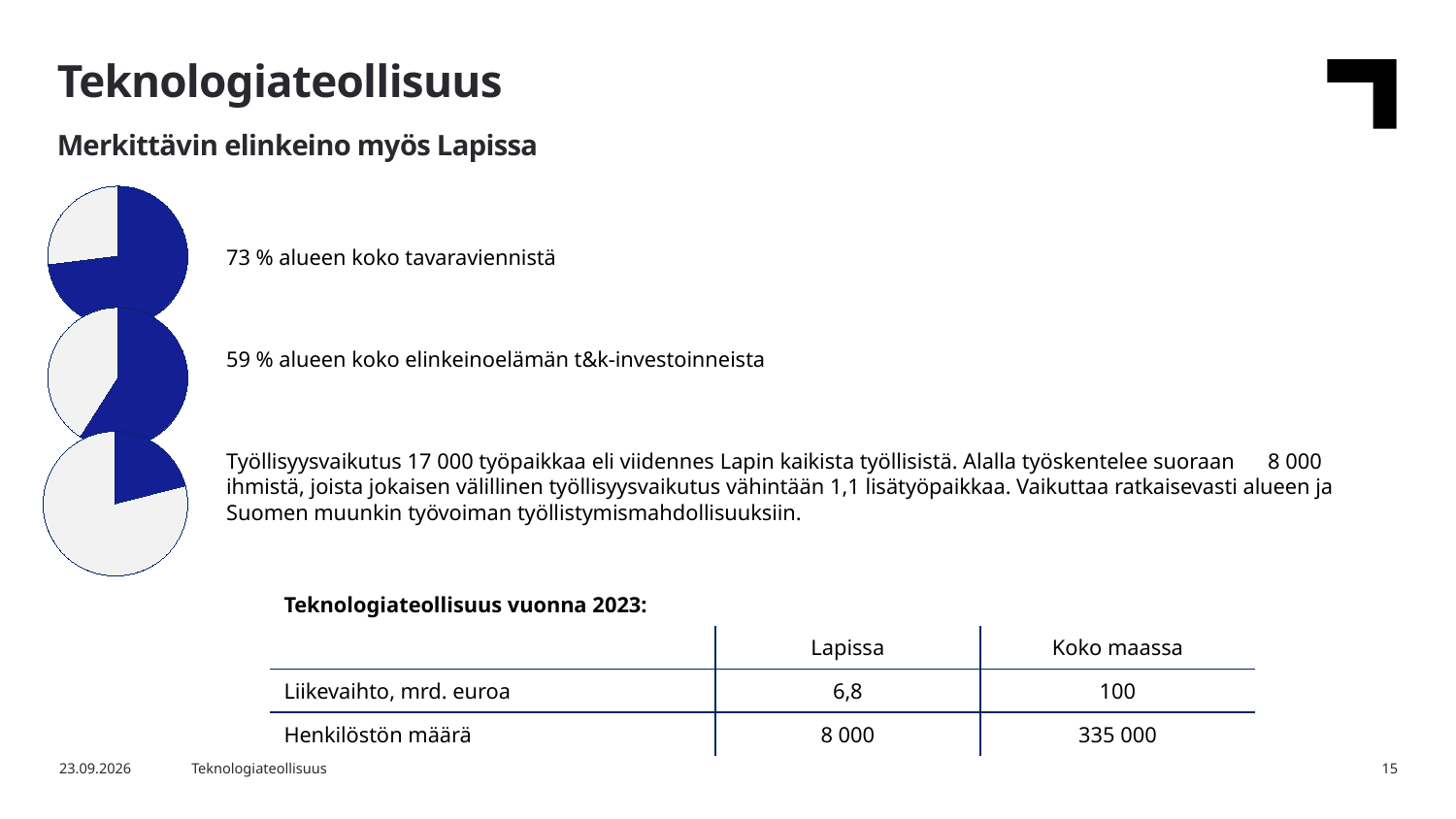
What kind of charts are shown on the left side of the slide? Pie charts What does the top pie chart's blue slice represent, according to the text next to it? 73 % alueen koko tavaraviennistä How many pie charts are on the slide? 3 Which of the three pie charts has the smallest blue slice? The bottom one Which of the three pie charts has the largest blue slice? The top one (73 %) What colour is used for the highlighted slice in each pie chart? Dark blue Is the blue slice in the top pie chart larger or smaller than the blue slice in the middle pie chart? Larger What is the difference in percentage points between the shares shown for the top and middle pie charts? 14 percentage points In the top pie chart, what share of the region's total goods exports does the blue slice represent? 73 % In the middle pie chart, what share of the region's business R&D investments does the blue slice represent? 59 % Is the blue slice in the bottom pie chart more or less than half of the pie? Less